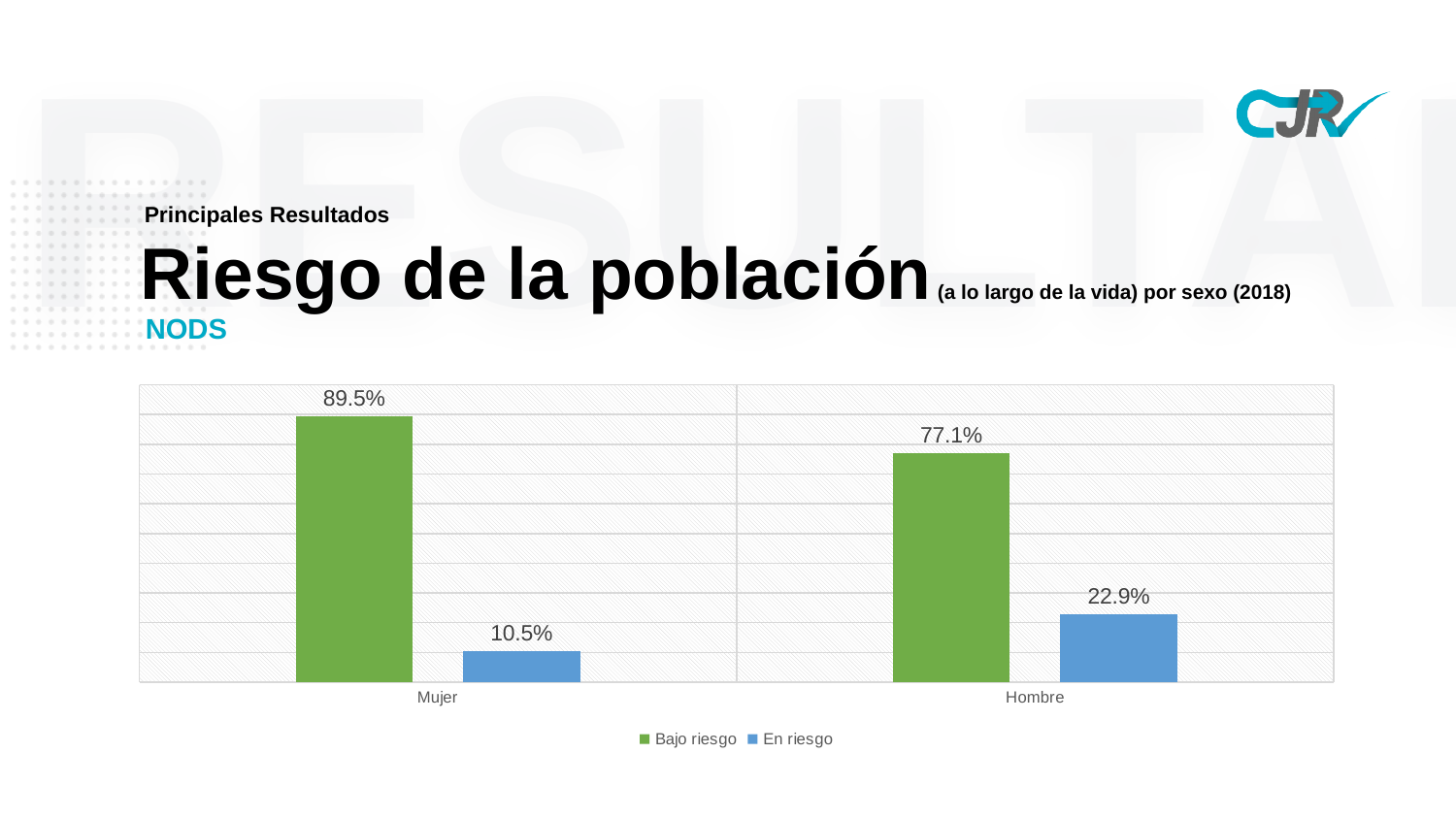
What is the value for Bajo riesgo for Hombre? 77.1% What is the value for Bajo riesgo for Mujer? 89.5% How many series does the legend list? 2 What is the value for En riesgo for Mujer? 10.5% Which category has the highest Bajo riesgo value? Mujer What is the difference between the Bajo riesgo values for Mujer and Hombre? 12.4% What is the difference between the En riesgo values for Hombre and Mujer? 12.4% What kind of chart is shown on the slide? Bar chart What is the value for En riesgo for Hombre? 22.9% Which is larger, En riesgo for Hombre or En riesgo for Mujer? Hombre Which category has the lowest En riesgo value? Mujer How many categories are shown on the x axis? 2